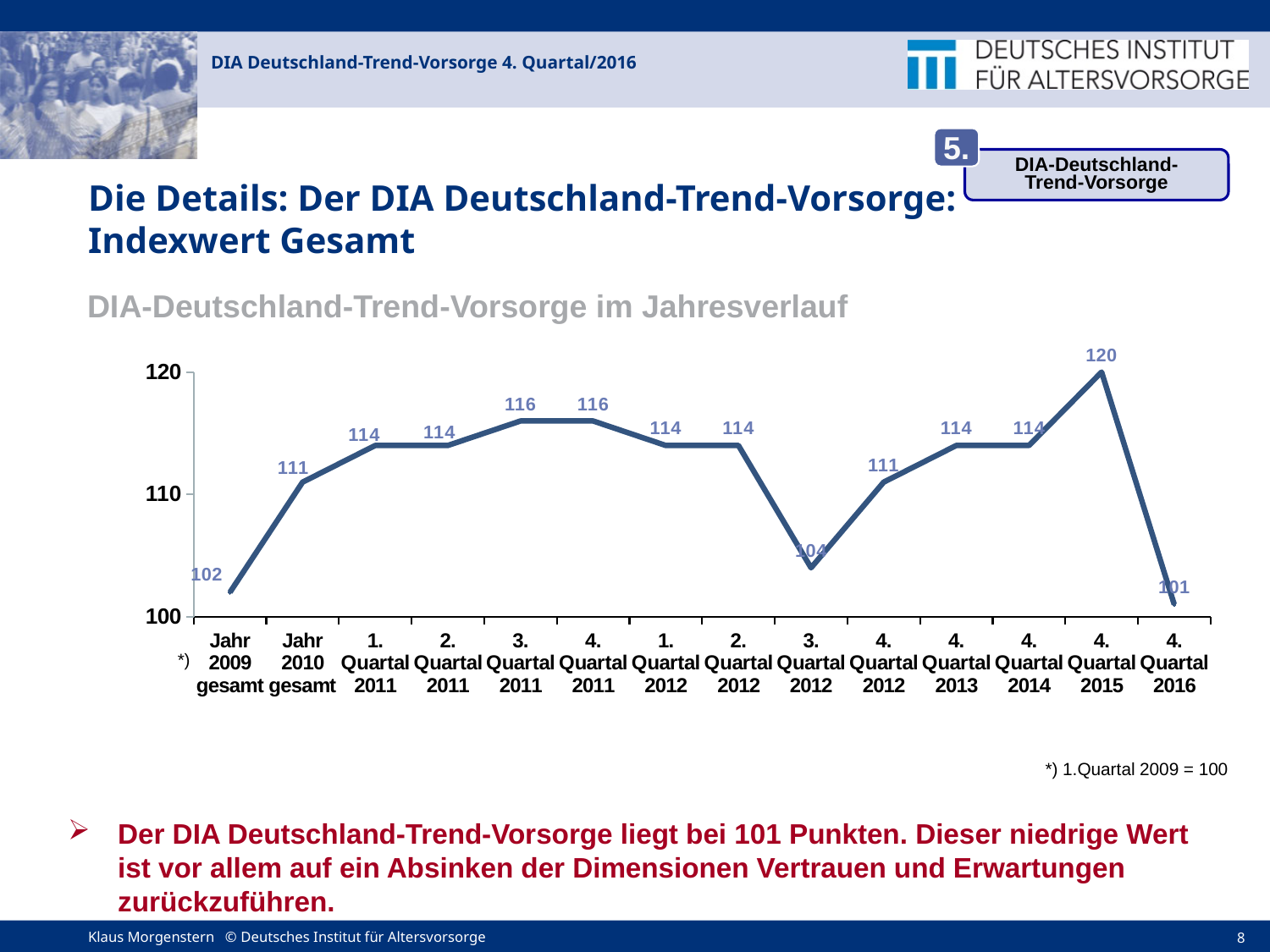
Which point on the x axis has the lowest index value? 4. Quartal 2016 How many data points are plotted on the line? 14 What is the index value for 3. Quartal 2012? 104 What is the index value for Jahr 2009 gesamt? 102 What type of chart is shown on the slide? line chart Which is larger, the index value for 3. Quartal 2011 or for 4. Quartal 2012? 3. Quartal 2011 Does the index value rise or fall from 4. Quartal 2015 to 4. Quartal 2016? fall Which point on the x axis has the highest index value? 4. Quartal 2015 What is the index value for 4. Quartal 2015? 120 What is the difference between the index values for 4. Quartal 2015 and 4. Quartal 2016? 19 What is the index value for 4. Quartal 2016? 101 What is the title of the chart? DIA-Deutschland-Trend-Vorsorge im Jahresverlauf